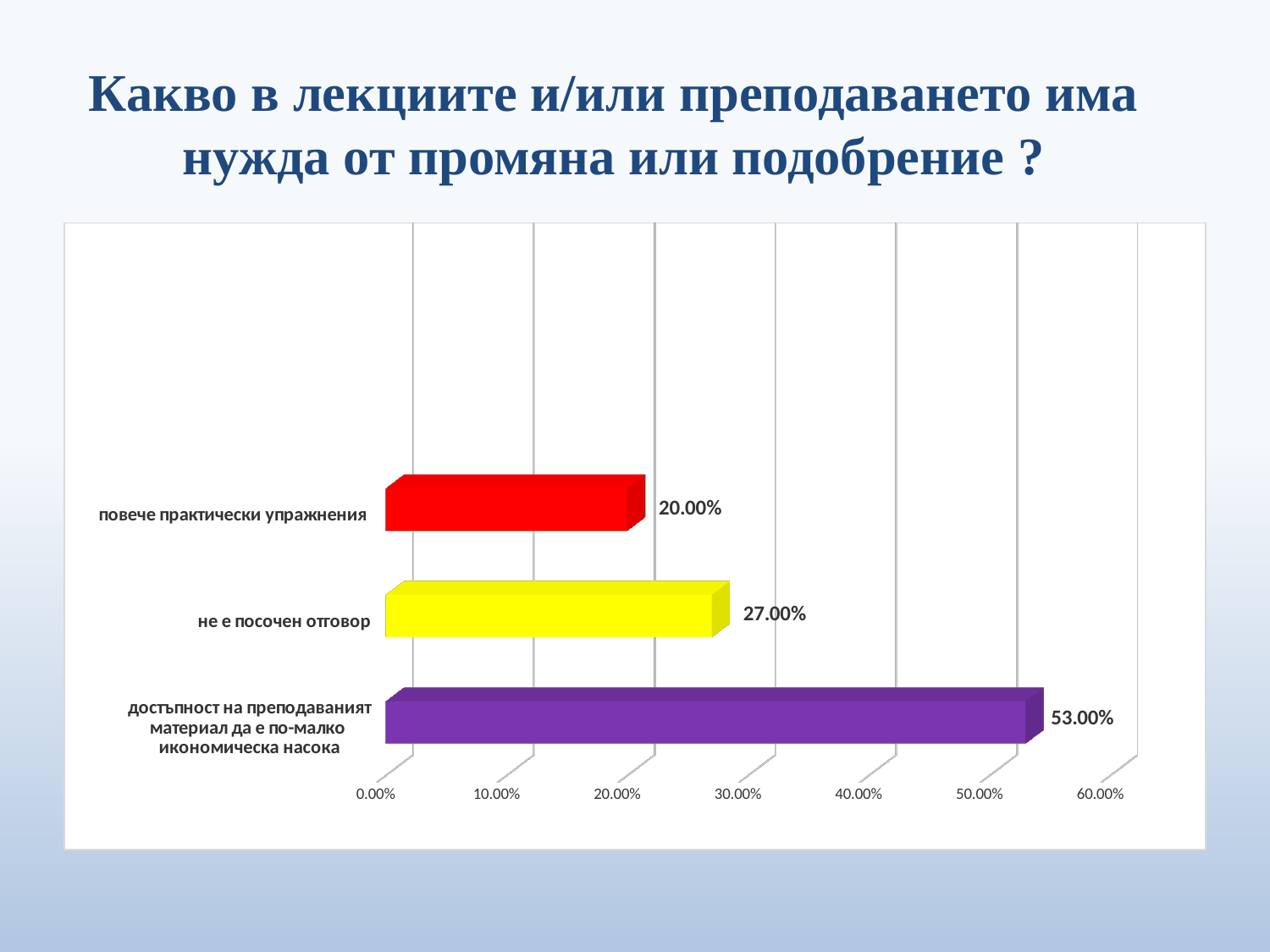
What is the value for "повече практически упражнения"? 20.00% What is the difference between the values for "не е посочен отговор" and "повече практически упражнения"? 7.00% What kind of chart is shown on the slide? bar chart What is the value for "не е посочен отговор"? 27.00% What is the value for "достъпност на преподаваният материал да е по-малко икономическа насока"? 53.00% Which category has the lowest value? повече практически упражнения Is the value for "достъпност на преподаваният материал да е по-малко икономическа насока" greater or less than 50.00%? greater Which is larger: the value for "не е посочен отговор" or the value for "повече практически упражнения"? не е посочен отговор Which category has the highest value? достъпност на преподаваният материал да е по-малко икономическа насока What is the difference between the values for "достъпност на преподаваният материал да е по-малко икономическа насока" and "не е посочен отговор"? 26.00% How many categories are shown in the chart? 3 What colour is the bar for "не е посочен отговор"? yellow